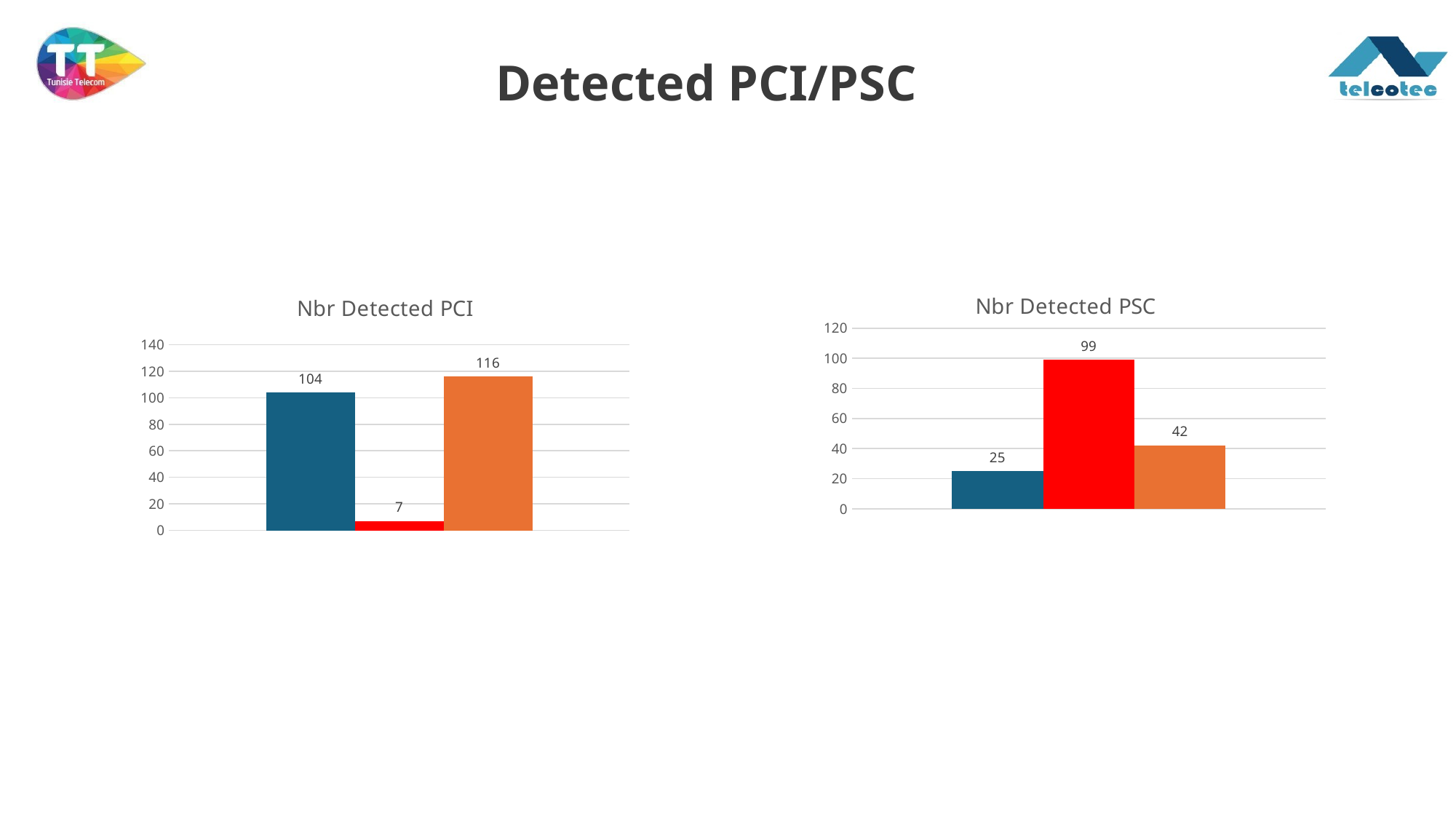
In the 'Nbr Detected PSC' chart, which bar has the highest value? the red bar In the 'Nbr Detected PCI' chart, what is the value of the dark blue bar? 104 In the 'Nbr Detected PCI' chart, which bar has the lowest value? the red bar In the 'Nbr Detected PSC' chart, what is the difference between the red bar and the dark blue bar? 74 In the 'Nbr Detected PCI' chart, what is the value of the orange bar? 116 In the 'Nbr Detected PCI' chart, what is the value of the red bar? 7 In the 'Nbr Detected PCI' chart, what is the difference between the orange bar and the dark blue bar? 12 In the 'Nbr Detected PSC' chart, what is the value of the red bar? 99 In the 'Nbr Detected PSC' chart, what is the value of the orange bar? 42 How many bars are plotted in the 'Nbr Detected PCI' chart? 3 What type of chart is the 'Nbr Detected PSC' chart? bar chart In the 'Nbr Detected PSC' chart, is the orange bar or the dark blue bar larger? the orange bar